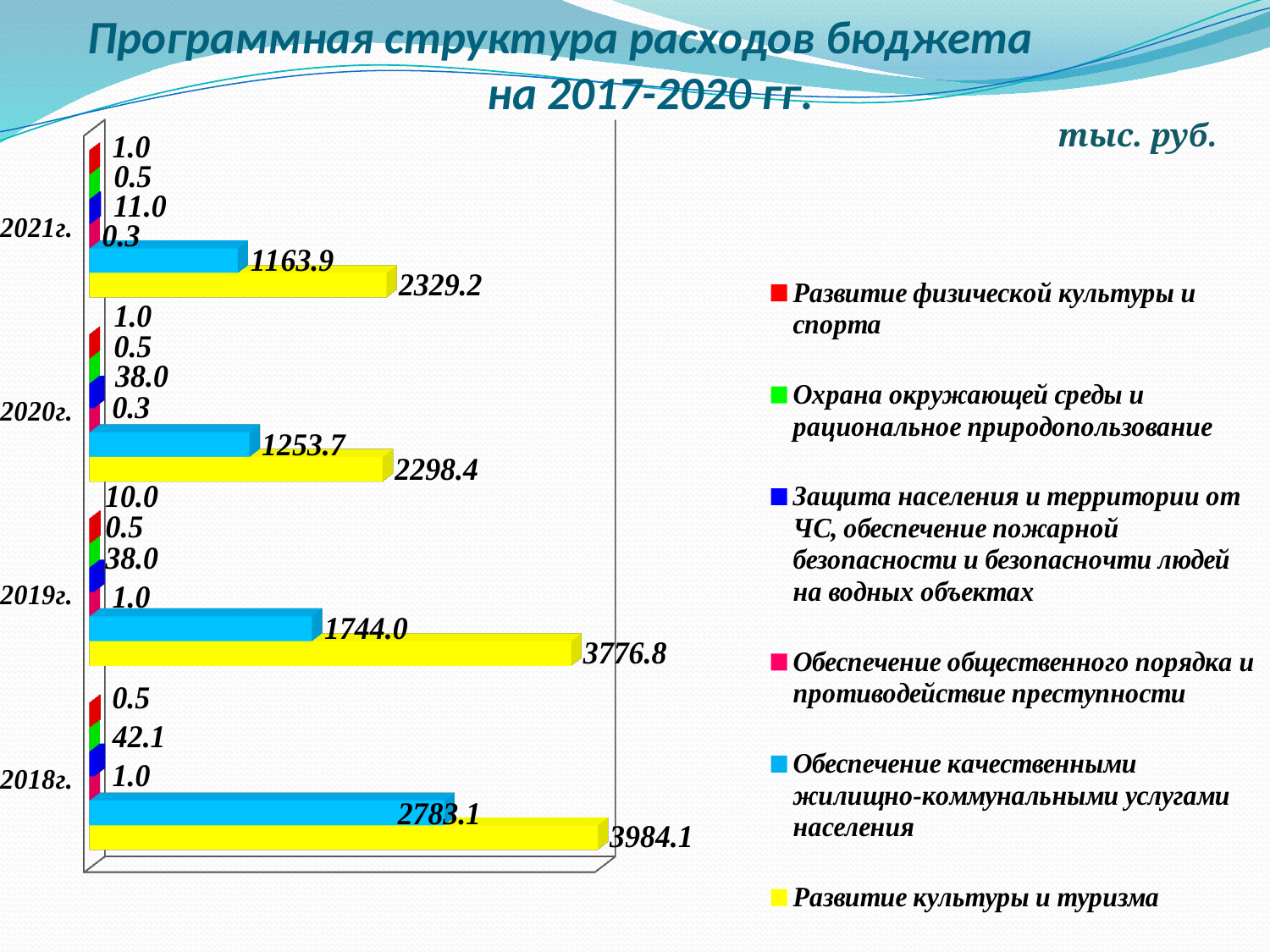
What is the value for Развитие культуры и туризма in 2018г.? 3984.1 What is the value for Обеспечение качественными жилищно-коммунальными услугами населения in 2021г.? 1163.9 Which is larger in 2021г.: Развитие культуры и туризма or Обеспечение качественными жилищно-коммунальными услугами населения? Развитие культуры и туризма In which year is the value for Обеспечение качественными жилищно-коммунальными услугами населения the lowest? 2021г. What kind of chart is shown on the slide? Bar chart How many series does the legend list? 6 What is the value for Развитие культуры и туризма in 2020г.? 2298.4 What is the difference between Развитие культуры и туризма and Обеспечение качественными жилищно-коммунальными услугами населения in 2019г.? 2032.8 What is the value for Защита населения и территории от ЧС in 2020г.? 38.0 How many years are shown on the chart? 4 Does the value for Обеспечение качественными жилищно-коммунальными услугами населения rise or fall from 2018г. to 2021г.? Fall In which year is the value for Развитие культуры и туризма the highest? 2018г.